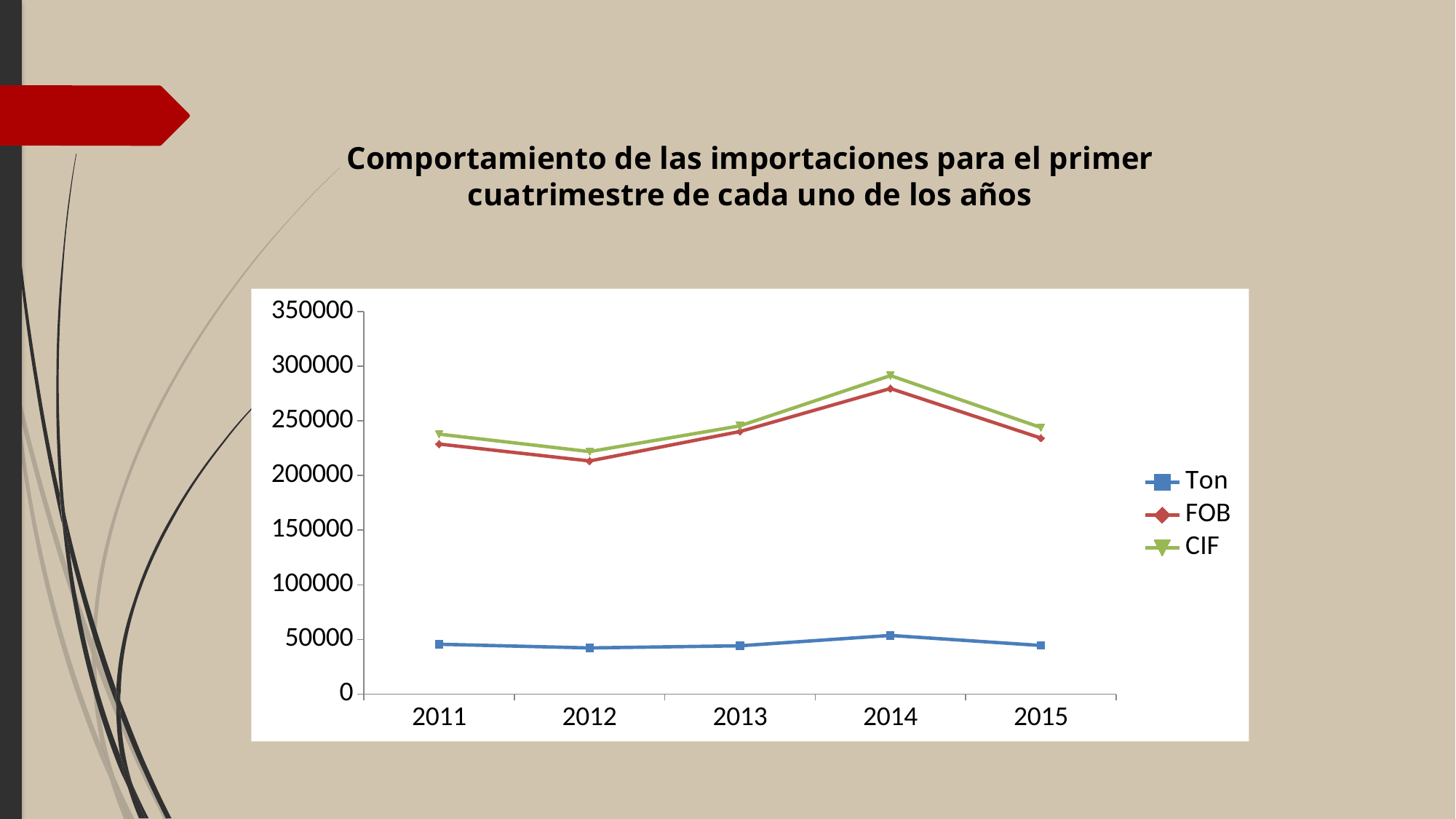
Is the value for CIF in 2012 greater or less than 250000? less How many years are plotted along the x axis? 5 Is the value for FOB in 2014 greater or less than 250000? greater What kind of chart is shown on the slide? line chart In which year does the Ton series reach its highest value? 2014 In 2014, which series has the larger value, CIF or FOB? CIF Does the FOB series rise or fall from 2012 to 2014? rise Is the value for Ton in 2014 greater or less than 100000? less How many series does the legend list? 3 What is the title of the chart? Comportamiento de las importaciones para el primer cuatrimestre de cada uno de los años In which year does the CIF series reach its highest value? 2014 In which year does the FOB series reach its lowest value? 2012